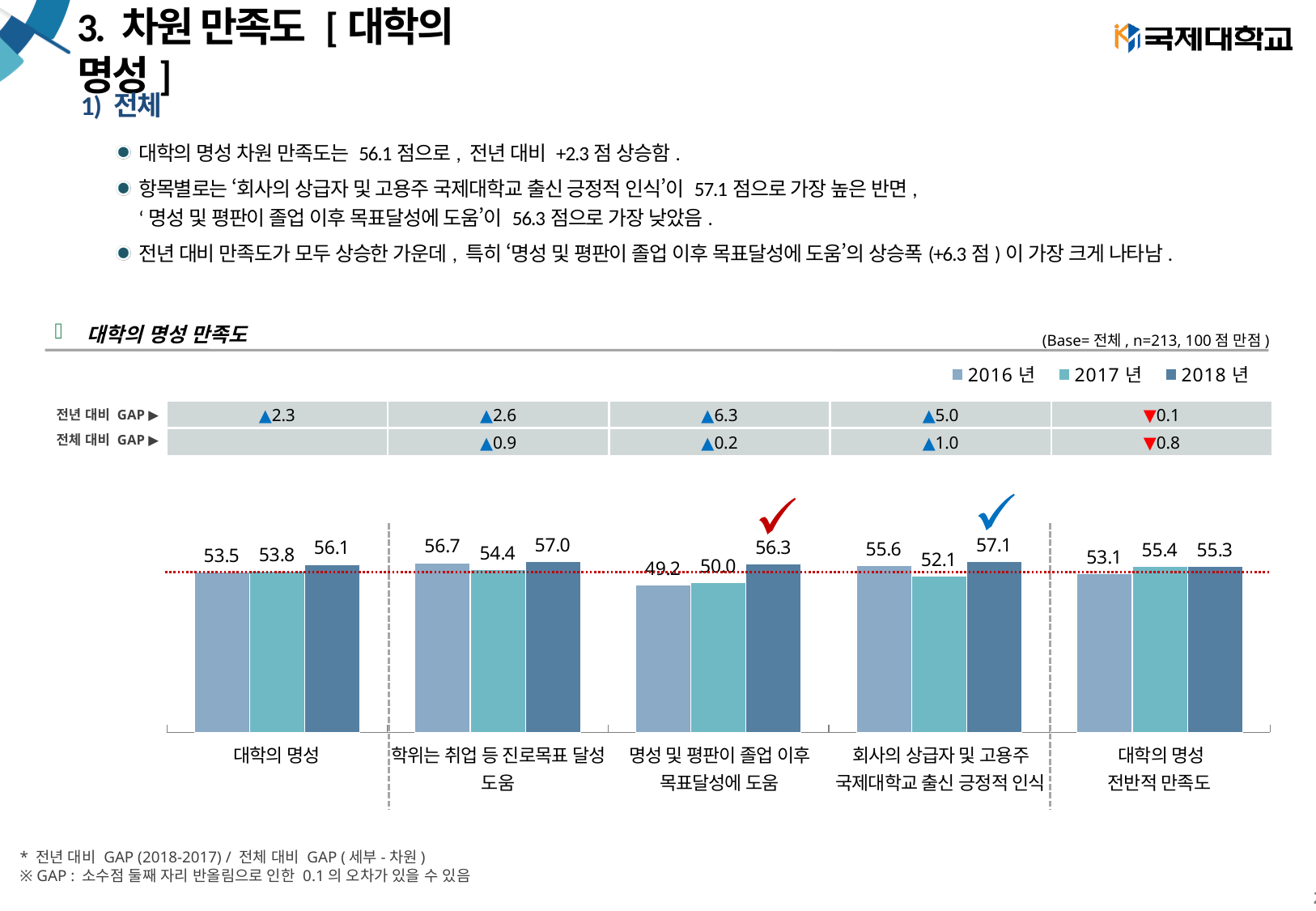
What is the difference between the 2018년 and 2017년 values for 명성 및 평판이 졸업 이후 목표달성에 도움? 6.3 What is the 2017년 value for 회사의 상급자 및 고용주 국제대학교 출신 긍정적 인식? 52.1 For 명성 및 평판이 졸업 이후 목표달성에 도움, do the values rise or fall from 2016년 to 2018년? Rise What is the title of the chart? 대학의 명성 만족도 What kind of chart is shown on the slide? Bar chart What is the 2018년 value for 대학의 명성? 56.1 Which is larger for 학위는 취업 등 진로목표 달성 도움: the 2016년 value or the 2017년 value? 2016년 Which category has the highest 2018년 value? 회사의 상급자 및 고용주 국제대학교 출신 긍정적 인식 What is the 2016년 value for 명성 및 평판이 졸업 이후 목표달성에 도움? 49.2 How many categories are shown on the x axis of the chart? 5 How many series does the legend list? 3 Which category has the lowest 2016년 value? 명성 및 평판이 졸업 이후 목표달성에 도움